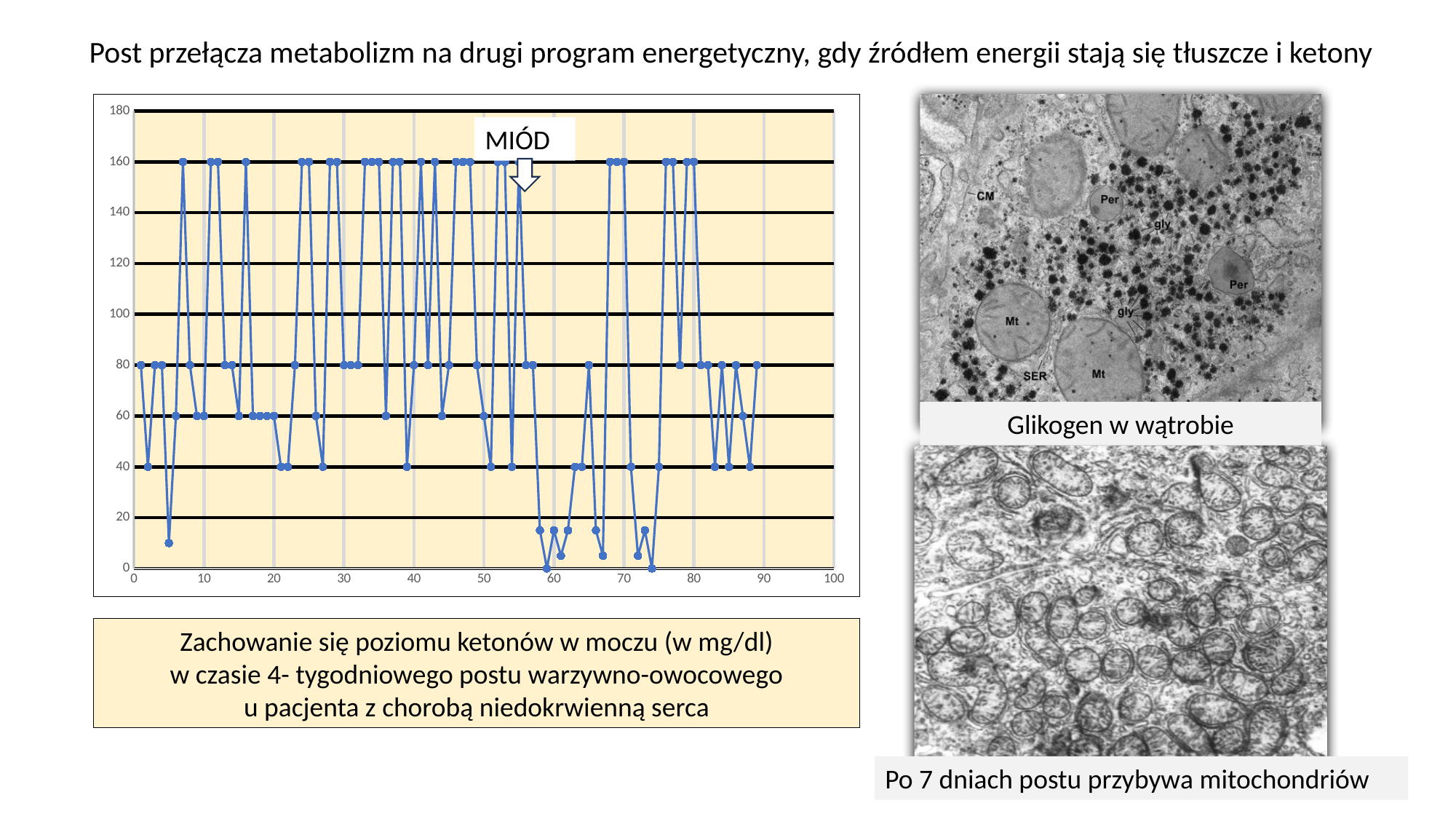
Is the value at x = 20 greater or less than 100? less What is the maximum value shown on the chart's vertical axis? 180 What is the highest value reached by the line in the chart? 160 Is the value at x = 70 greater or less than 100? greater Is the value at x = 5 greater or less than 20? less What label is written above the arrow annotation on the chart? MIÓD What kind of chart is shown on the left of the slide? line chart What is the lowest value reached by the line in the chart? 0